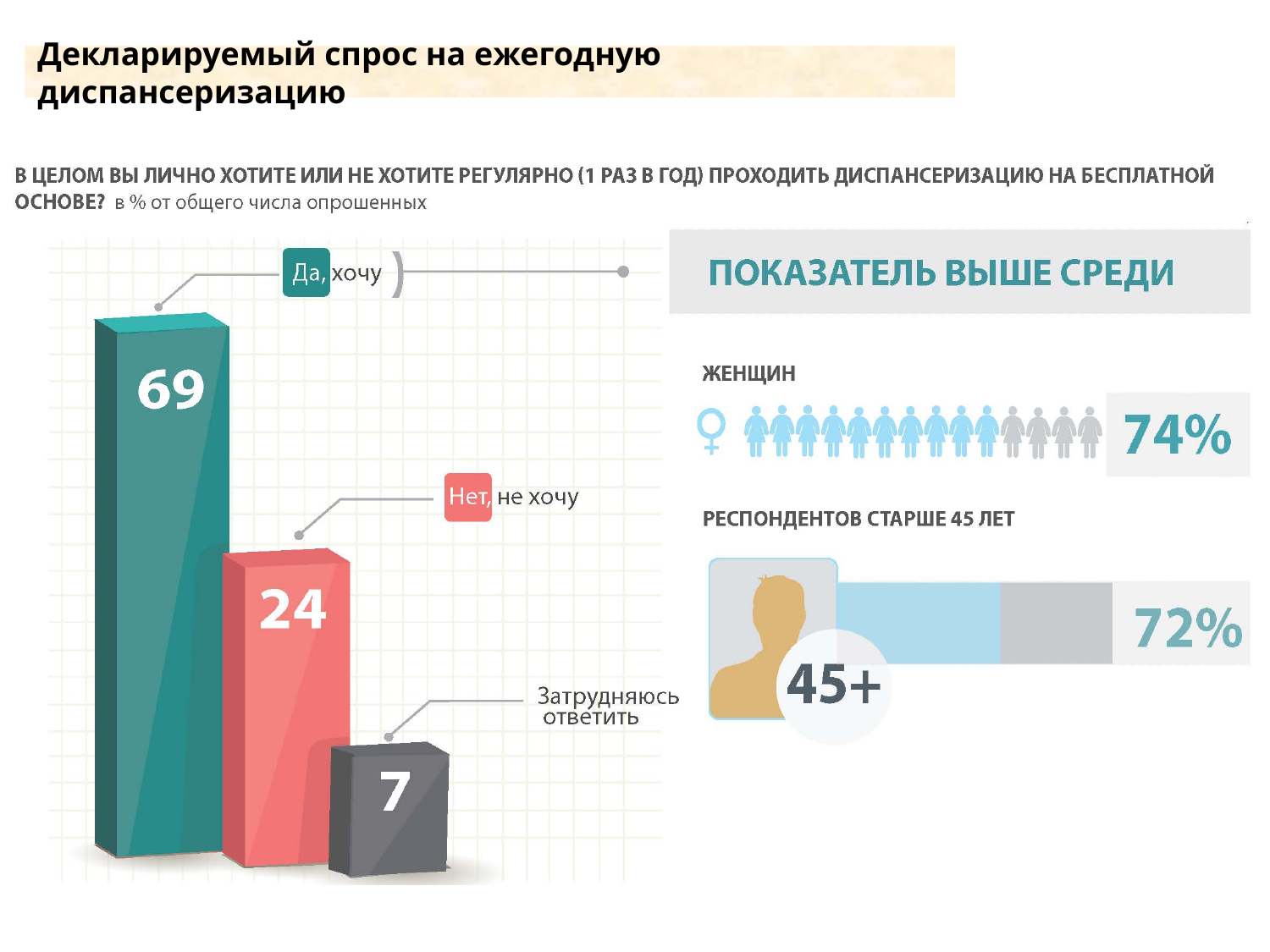
What is the difference between the values for "Да, хочу" and "Нет, не хочу"? 45 What is the value for "Затрудняюсь ответить" in the bar chart? 7 Which category has the lowest value in the bar chart? Затрудняюсь ответить Which is larger: the value for "Нет, не хочу" or the value for "Затрудняюсь ответить"? Нет, не хочу How many categories are shown in the bar chart? 3 What is the value for "Да, хочу" in the bar chart? 69 What is the value for "Нет, не хочу" in the bar chart? 24 What kind of chart is used to show the answers to the question on the slide? Bar chart According to the infographic on the right, what is the share of women who want to undergo the annual check-up? 74% What is the difference between the values for "Нет, не хочу" and "Затрудняюсь ответить"? 17 According to the infographic on the right, what is the share among respondents older than 45 years? 72% Which category has the highest value in the bar chart? Да, хочу